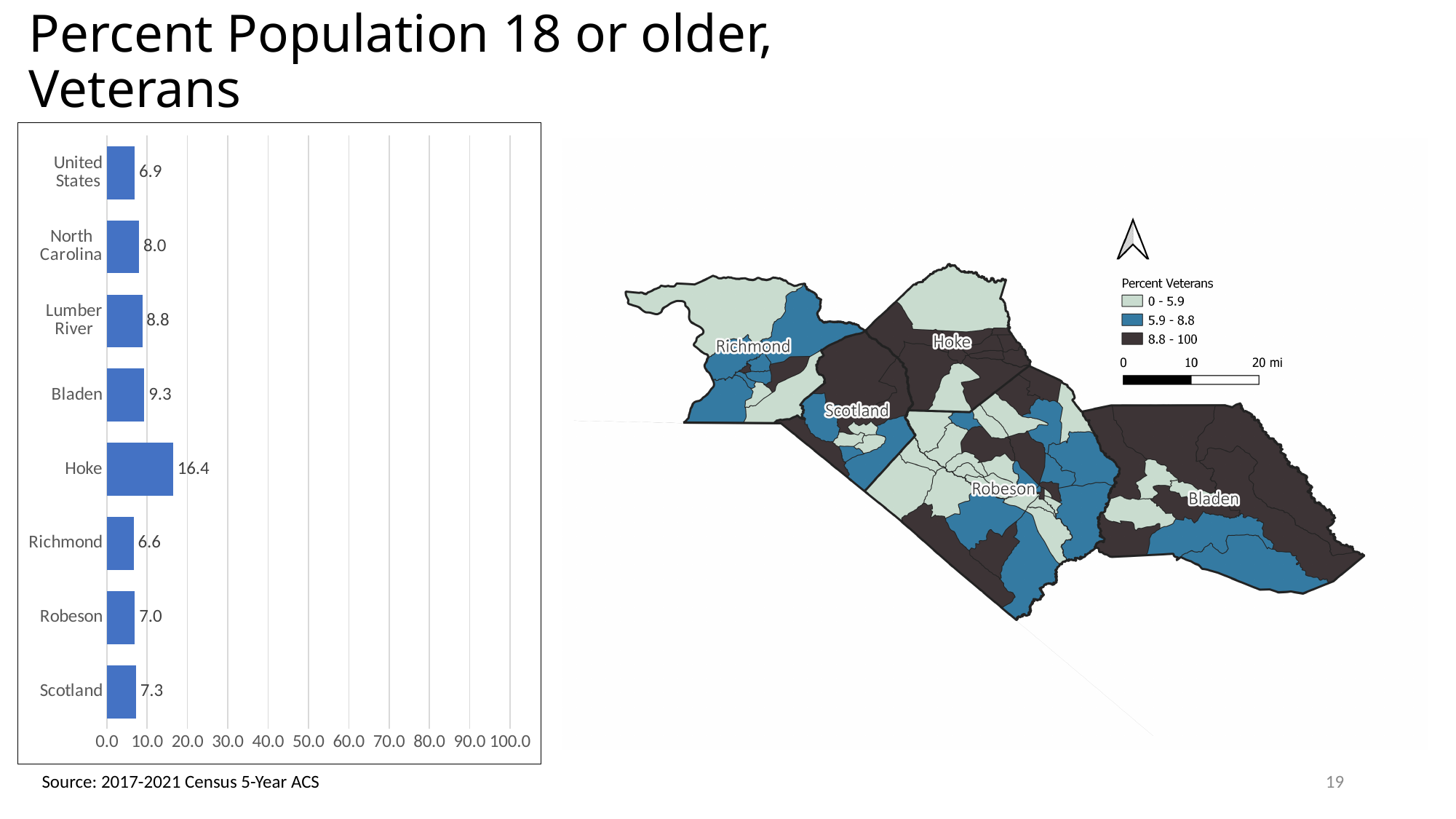
What is the value for Lumber River in the bar chart? 8.8 Which category has the highest value in the bar chart? Hoke How many categories are shown in the bar chart? 8 What is the difference between the values for Scotland and Robeson in the bar chart? 0.3 Is the value for Hoke in the bar chart greater or less than 20.0? less What is the value for North Carolina in the bar chart? 8.0 What is the value for Richmond in the bar chart? 6.6 What kind of chart is shown on the left of the slide? bar chart What is the difference between the values for Hoke and Bladen in the bar chart? 7.1 What is the value for Hoke in the bar chart? 16.4 Which is larger in the bar chart, the value for Bladen or the value for United States? Bladen Which category has the lowest value in the bar chart? Richmond